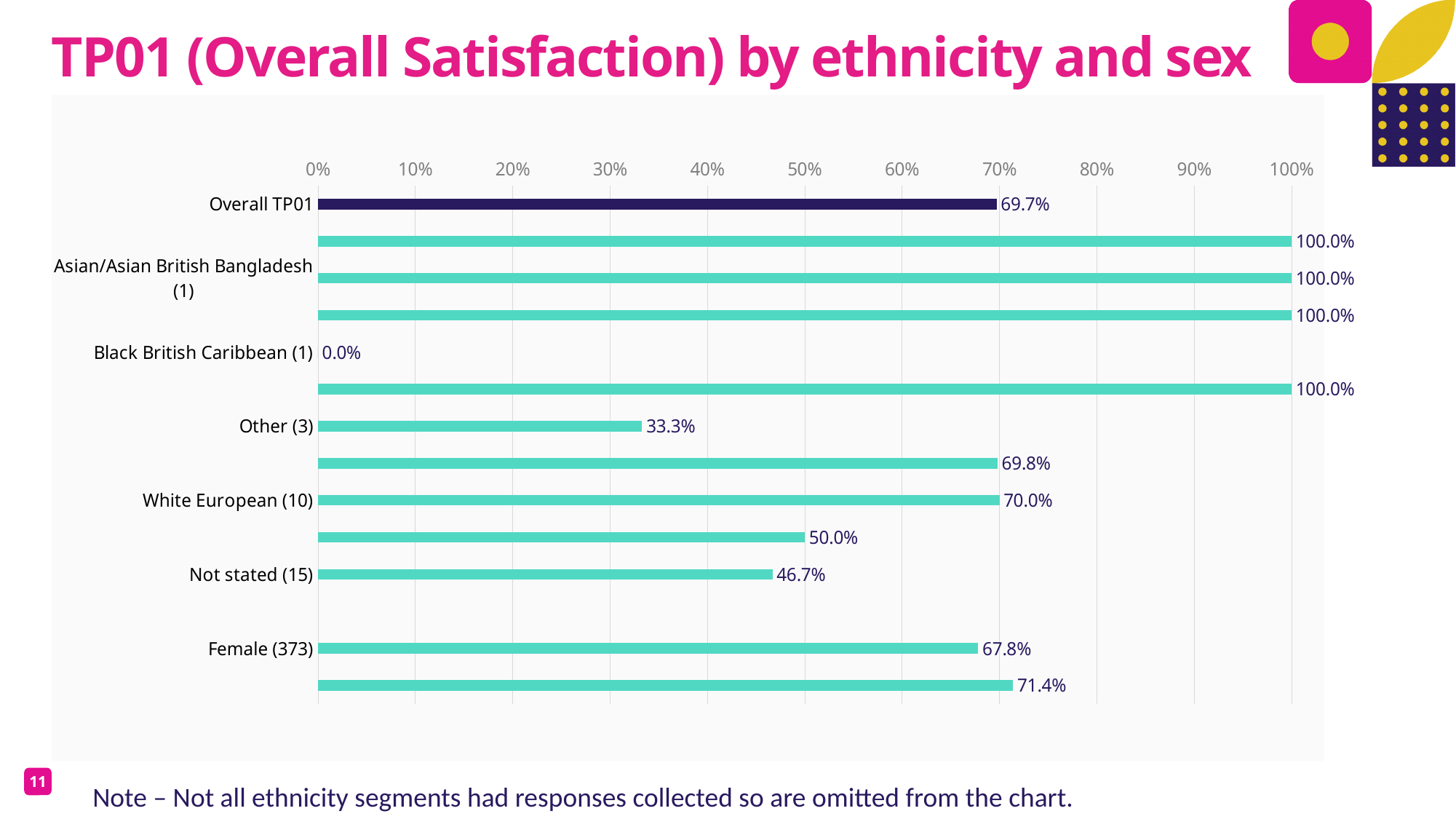
What is the difference between the values for White European (10) and Other (3)? 36.7 percentage points What is the value for White European (10)? 70.0% What is the value for Other (3)? 33.3% Which category has the lowest value on the chart? Black British Caribbean (1) What is the title of the slide? TP01 (Overall Satisfaction) by ethnicity and sex What is the value for Asian/Asian British Bangladesh (1)? 100.0% What is the value for Black British Caribbean (1)? 0.0% Which is larger, the value for Female (373) or the value for Not stated (15)? Female (373) What kind of chart is shown on the slide? Bar chart What is the value for Female (373)? 67.8% What is the value for Overall TP01? 69.7% What is the value for Not stated (15)? 46.7%